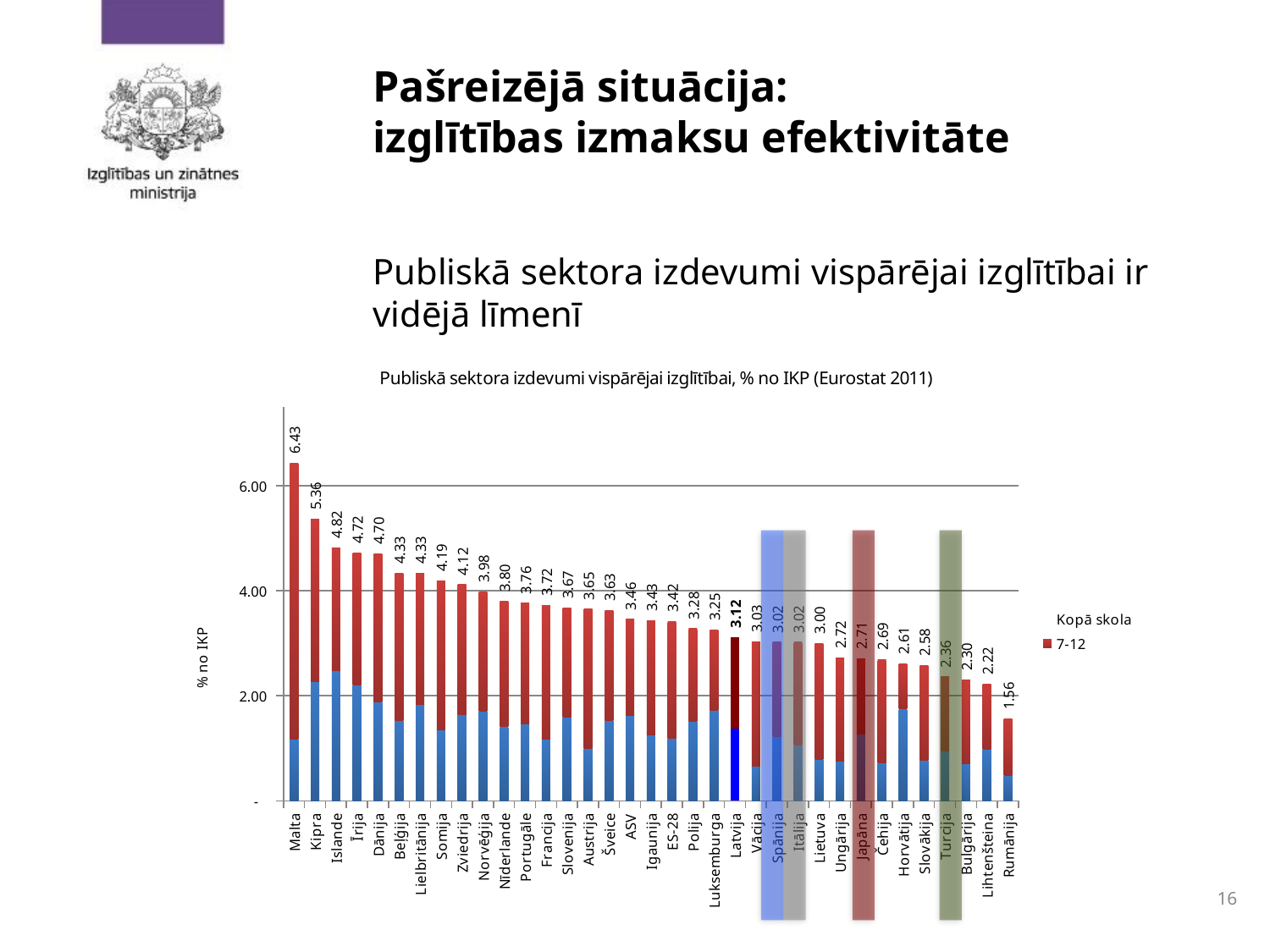
Which country has the lowest total value in the chart? Rumānija What type of chart is shown on the slide? Stacked bar chart Which has a larger total value, Kipra or Islande? Kipra How many countries or regions are shown on the x axis of the chart? 35 What is the label on the vertical axis of the chart? % no IKP What is the total value shown for Latvija? 3.12 What is the total value shown for ES-28? 3.42 Do the total values rise or fall moving from left to right along the x axis? Fall How many entries does the chart legend list? 2 What is the difference between the total values for Malta and Rumānija? 4.87 What is the total value shown for Malta? 6.43 Which country has the highest total value in the chart? Malta